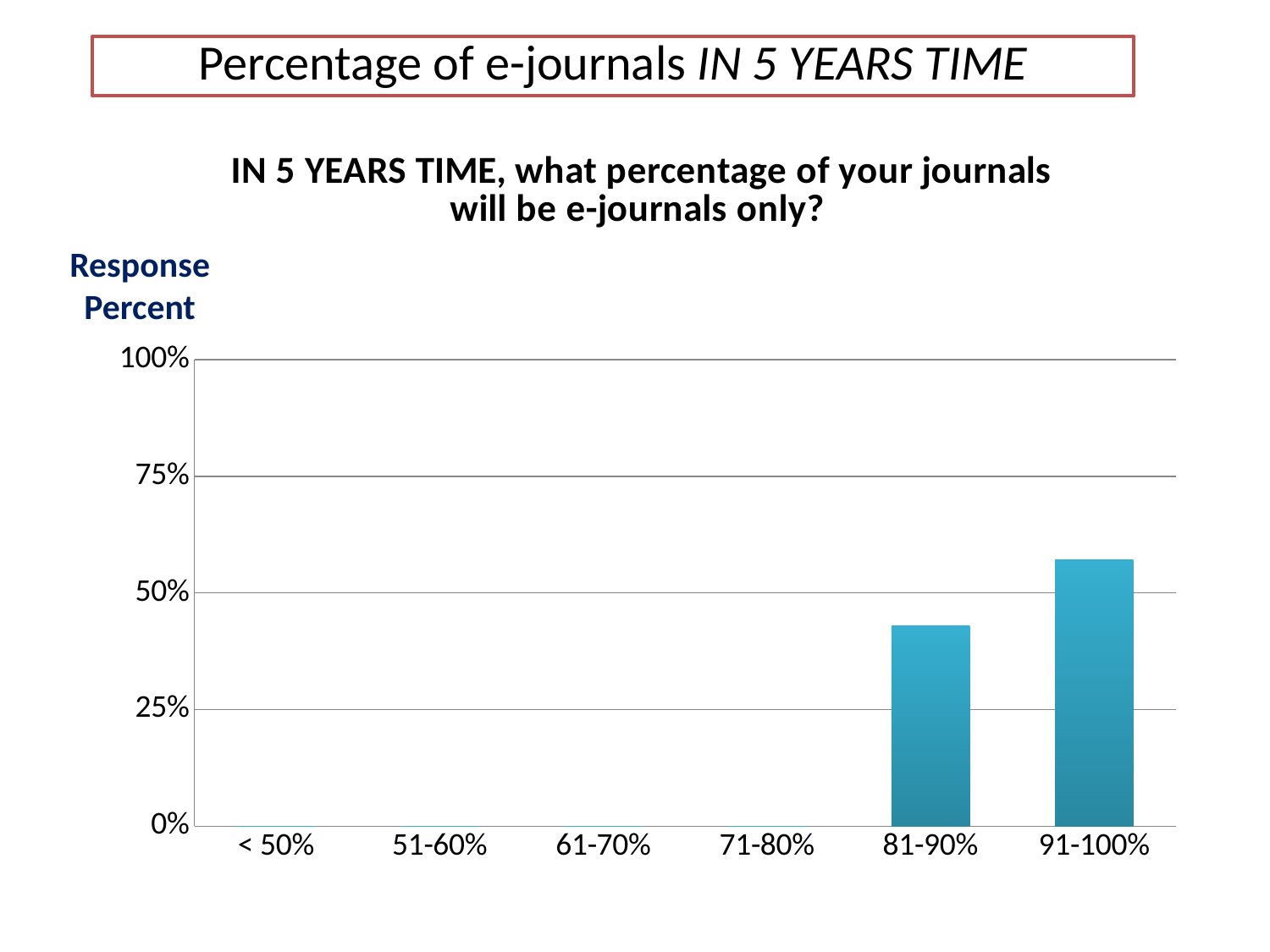
What kind of chart is shown on the slide? bar chart Is the value for 91-100% greater or less than 50%? greater Which category has the highest response percent? 91-100% What is the highest value shown on the vertical axis? 100% What is the label on the vertical axis of the chart? Response Percent Is the value for 81-90% greater or less than 50%? less Do the values generally rise or fall moving from left to right along the x axis? rise What is the response percent for the < 50% category? 0% Is the value for 91-100% greater or less than 75%? less Which is larger, the value for 81-90% or the value for 91-100%? 91-100% How many categories are shown on the x axis of the chart? 6